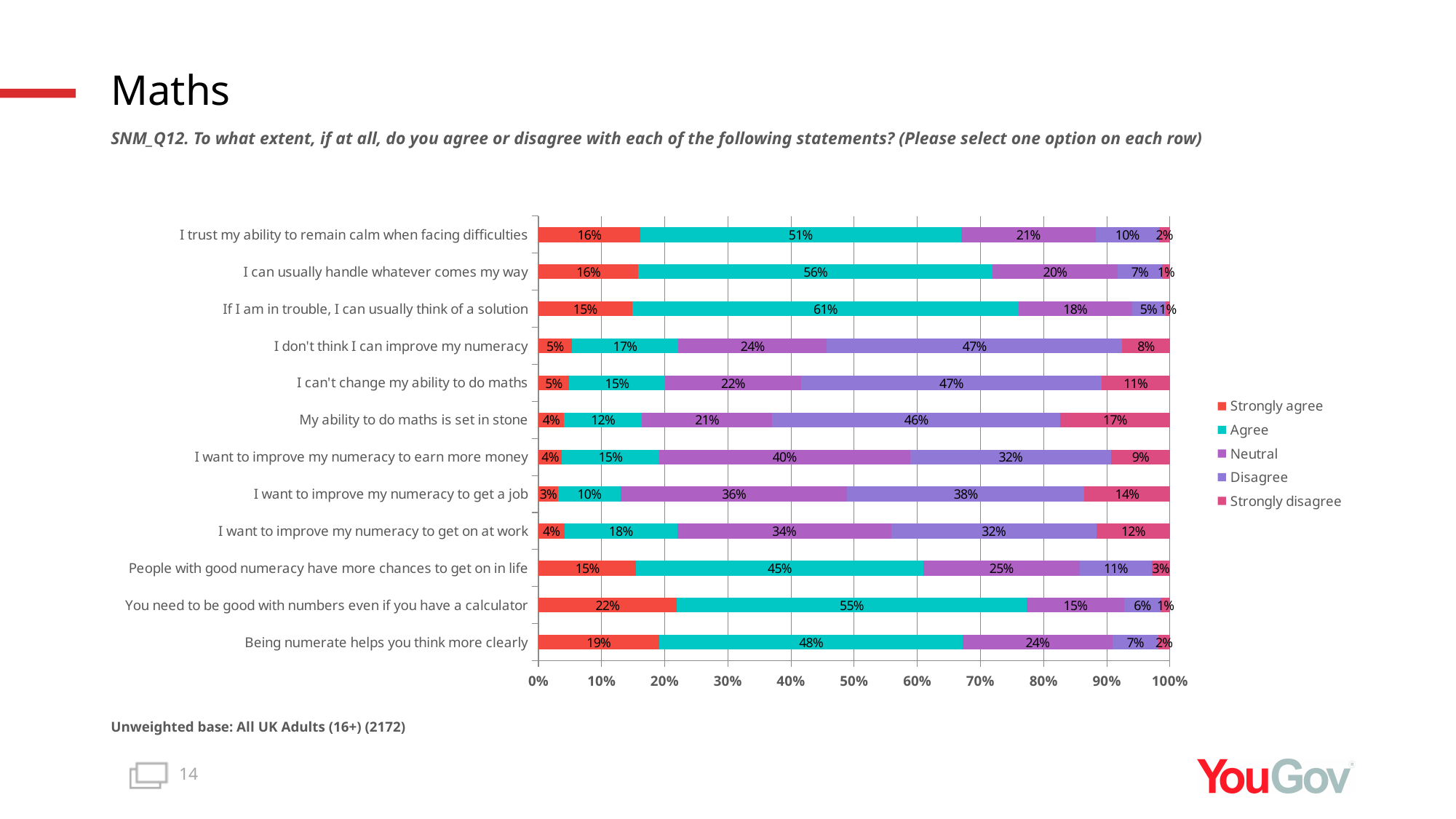
Which is larger: the 'Strongly disagree' value for 'My ability to do maths is set in stone' or for 'I want to improve my numeracy to get a job'? My ability to do maths is set in stone What kind of chart is shown on the slide? Stacked bar chart How many statements are listed on the chart? 12 What is the difference between the 'Agree' values for 'I can usually handle whatever comes my way' and 'I trust my ability to remain calm when facing difficulties'? 5% What percentage of respondents 'Agree' with the statement 'If I am in trouble, I can usually think of a solution'? 61% Which statement has the highest 'Agree' percentage? If I am in trouble, I can usually think of a solution What is the 'Neutral' value for 'I want to improve my numeracy to earn more money'? 40% How many series does the legend list? 5 What is the 'Strongly agree' value for 'You need to be good with numbers even if you have a calculator'? 22% Which statement has the lowest 'Strongly agree' percentage? I want to improve my numeracy to get a job What is the 'Disagree' value for 'I can't change my ability to do maths'? 47% Which legend entry is shown in red? Strongly agree